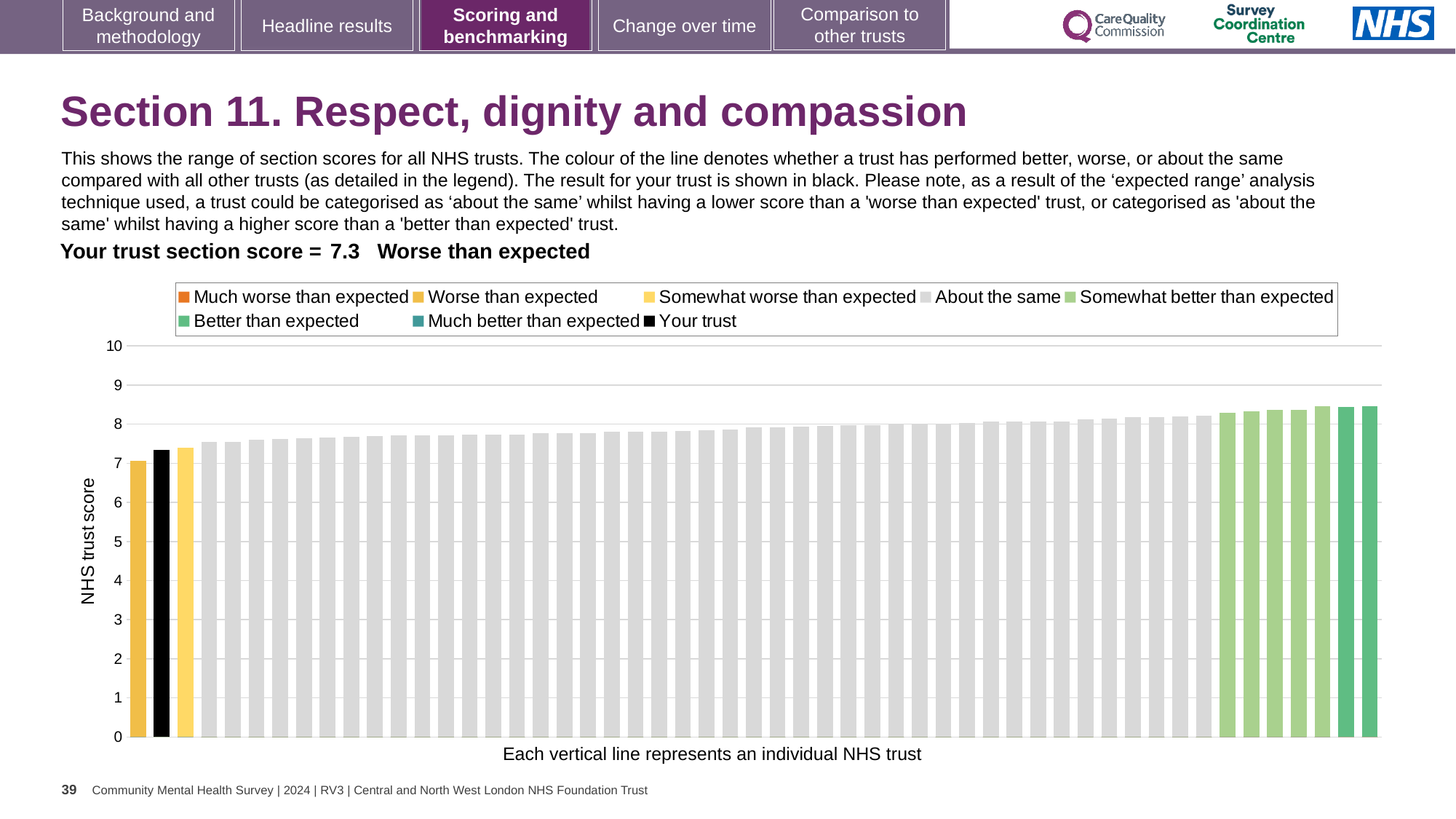
What is the section score for your trust shown on the slide? 7.3 How many entries does the chart legend list? 8 Which bar is the highest in the chart, the leftmost or the rightmost? Rightmost What is the label on the y axis of the chart? NHS trust score Is the value for the leftmost bar greater or less than 8? less Do the bar values rise or fall from left to right along the x axis? Rise Is the value for your trust's bar greater or less than 8? less Is the value for the rightmost bar greater or less than 8? greater Which is larger, the value for your trust's bar or the value for the rightmost bar? The rightmost bar What colour is used for your trust's bar in the chart? Black Which bar is the lowest in the chart, the leftmost or the rightmost? Leftmost What kind of chart is shown on the slide? Bar chart